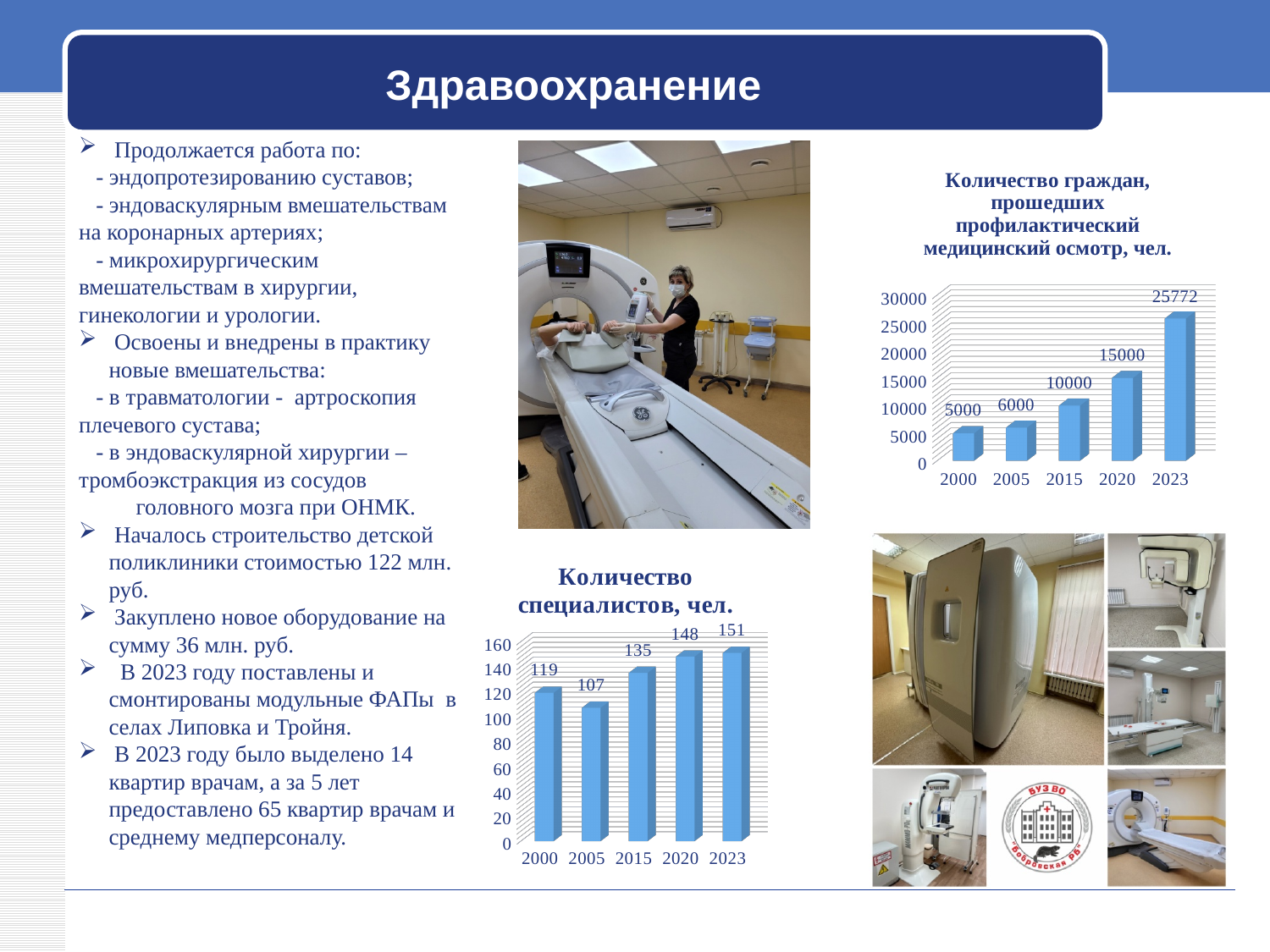
In the chart 'Количество специалистов, чел.', what is the value for 2015? 135 In the chart 'Количество специалистов, чел.', which year has the lowest value? 2005 In the chart 'Количество специалистов, чел.', which year has the highest value? 2023 In the chart 'Количество граждан, прошедших профилактический медицинский осмотр, чел.', what is the value for 2005? 6000 In the chart 'Количество граждан, прошедших профилактический медицинский осмотр, чел.', what is the difference between the values for 2023 and 2020? 10772 In the chart 'Количество граждан, прошедших профилактический медицинский осмотр, чел.', what is the value for 2023? 25772 In the chart 'Количество специалистов, чел.', which is larger, the value for 2000 or the value for 2015? 2015 In the chart 'Количество специалистов, чел.', what is the difference between the values for 2000 and 2005? 12 What kind of chart is 'Количество специалистов, чел.'? bar chart How many years are shown in the chart 'Количество граждан, прошедших профилактический медицинский осмотр, чел.'? 5 In the chart 'Количество граждан, прошедших профилактический медицинский осмотр, чел.', do the values rise or fall from 2000 to 2023? rise In the chart 'Количество граждан, прошедших профилактический медицинский осмотр, чел.', which year has the lowest value? 2000